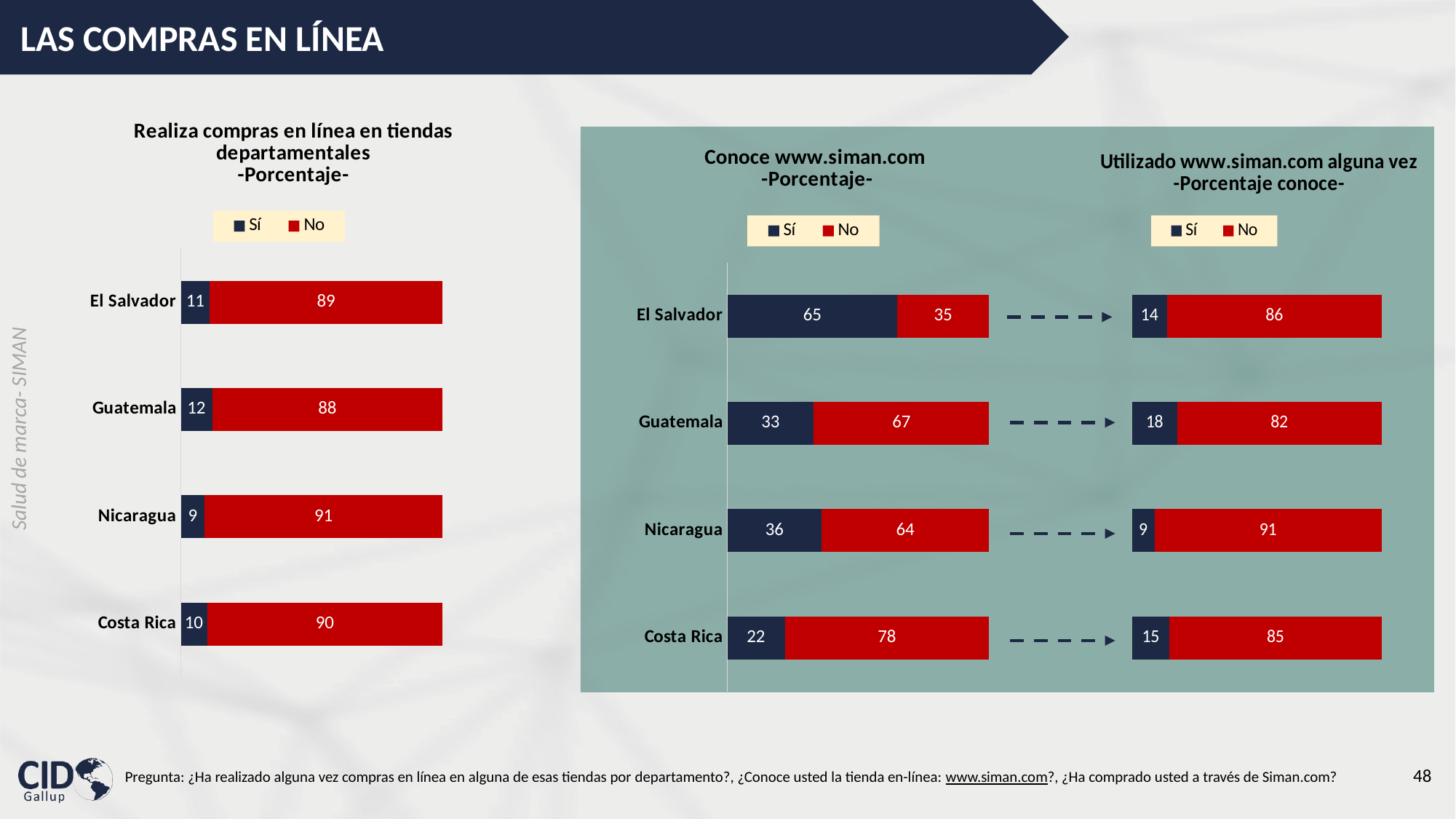
In the chart titled 'Realiza compras en línea en tiendas departamentales', which country has the lowest 'Sí' value? Nicaragua In the chart titled 'Conoce www.siman.com', what is the 'Sí' value for El Salvador? 65 In the chart titled 'Utilizado www.siman.com alguna vez', which country has the highest 'Sí' value? Guatemala What type of chart is the chart titled 'Conoce www.siman.com'? Stacked bar chart In the chart titled 'Utilizado www.siman.com alguna vez', what is the total of the stacked bar for Costa Rica? 100 In the chart titled 'Conoce www.siman.com', is the 'Sí' value larger for Nicaragua or Guatemala? Nicaragua In the chart titled 'Conoce www.siman.com', what is the difference between the 'No' values for Costa Rica and Guatemala? 11 In the chart titled 'Utilizado www.siman.com alguna vez', what is the 'No' value for Guatemala? 82 In the chart titled 'Realiza compras en línea en tiendas departamentales', what is the 'Sí' value for Guatemala? 12 In the chart titled 'Realiza compras en línea en tiendas departamentales', which country has the highest 'No' value? Nicaragua In the chart titled 'Conoce www.siman.com', which country has the highest 'Sí' value? El Salvador How many countries are shown in the chart titled 'Realiza compras en línea en tiendas departamentales'? 4